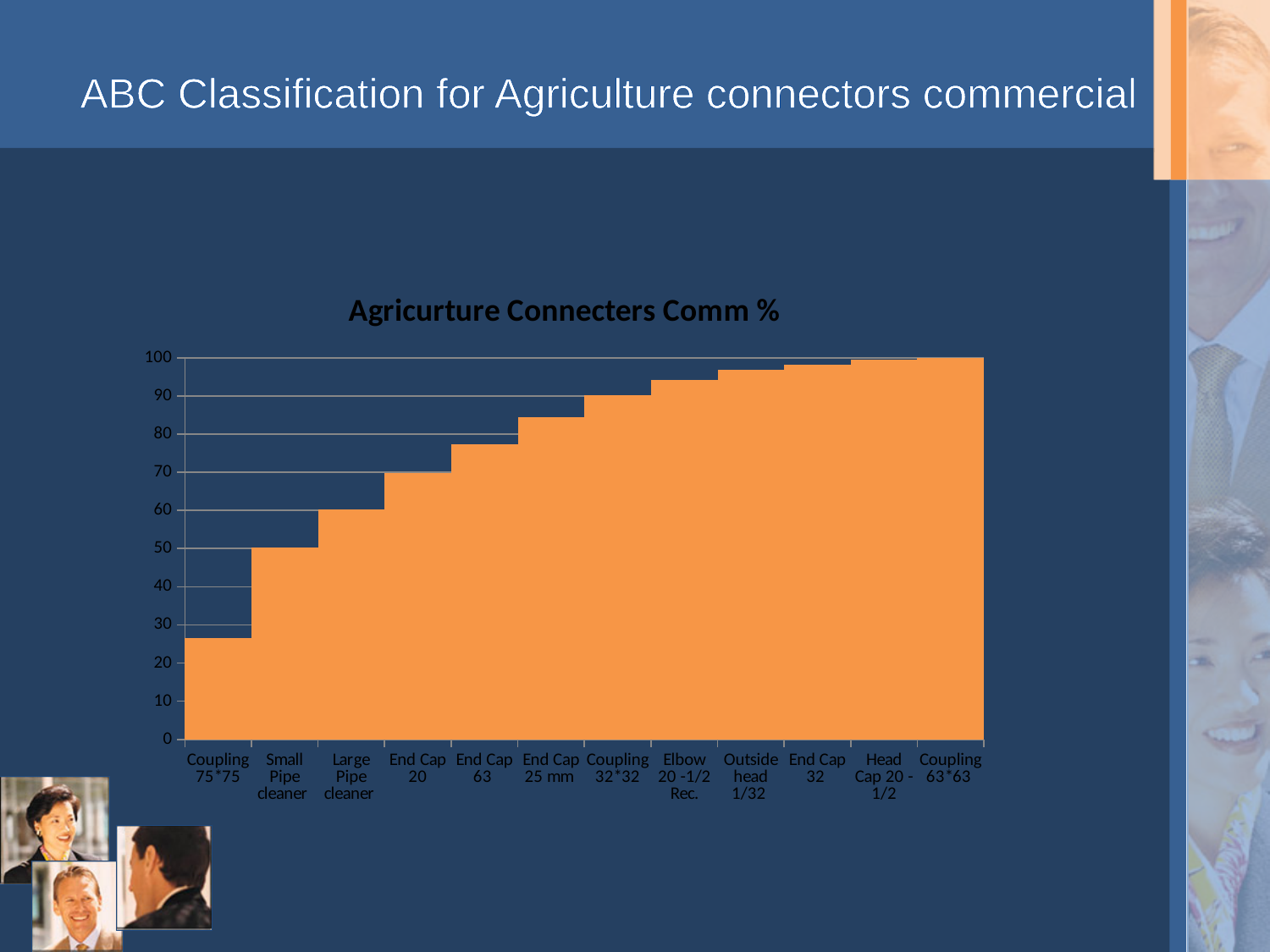
What is the value for Coupling 63*63? 100 How many categories are plotted along the x axis? 12 What kind of chart is shown on the slide? bar chart Which is larger, the value for End Cap 63 or the value for Coupling 75*75? End Cap 63 What is the title of the chart? Agricurture Connecters Comm % Is the value for Coupling 75*75 greater or less than 30? less Which category has the highest value? Coupling 63*63 Is the value for Elbow 20 -1/2 Rec. greater or less than 90? greater Which category has the lowest value? Coupling 75*75 Do the values rise or fall from left to right along the x axis? rise Is the value for End Cap 25 mm greater or less than 80? greater